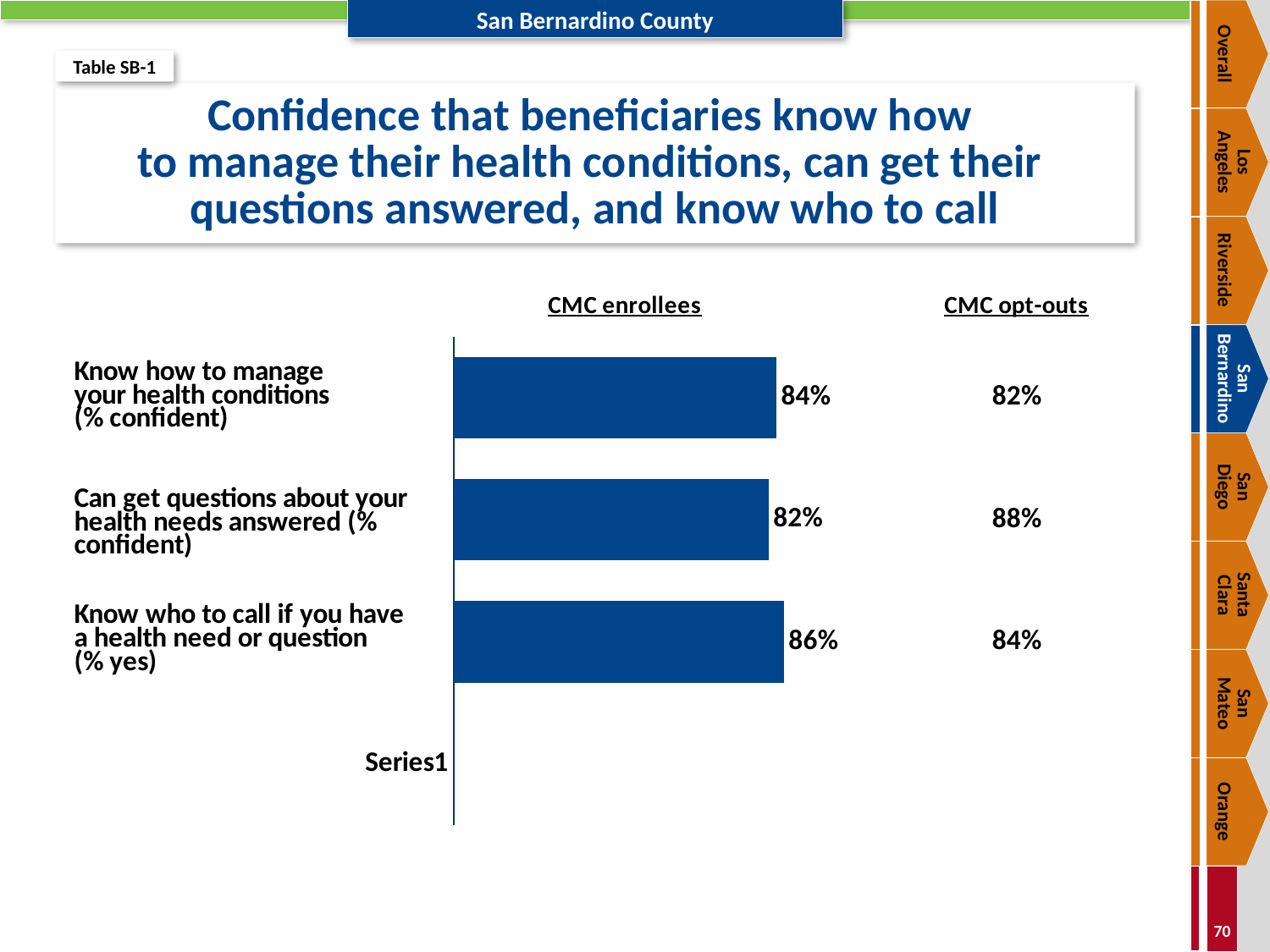
What is the CMC enrollees value for "Know who to call if you have a health need or question (% yes)"? 86% Which item has the highest CMC enrollees value? Know who to call if you have a health need or question (% yes) What is the CMC opt-outs value printed for "Can get questions about your health needs answered (% confident)"? 88% What kind of chart is shown on the slide? bar chart For "Can get questions about your health needs answered", which is larger: the CMC enrollees value or the CMC opt-outs value? CMC opt-outs What is the CMC enrollees value for "Know how to manage your health conditions (% confident)"? 84% What are the two column headings shown above the data? CMC enrollees and CMC opt-outs For "Know how to manage your health conditions", which is larger: the CMC enrollees value or the CMC opt-outs value? CMC enrollees What is the CMC enrollees value for "Can get questions about your health needs answered (% confident)"? 82% What is the difference between the CMC enrollees values for "Know who to call if you have a health need or question" and "Can get questions about your health needs answered"? 4% How many items (bars) are plotted in the chart? 3 Which item has the lowest CMC enrollees value? Can get questions about your health needs answered (% confident)